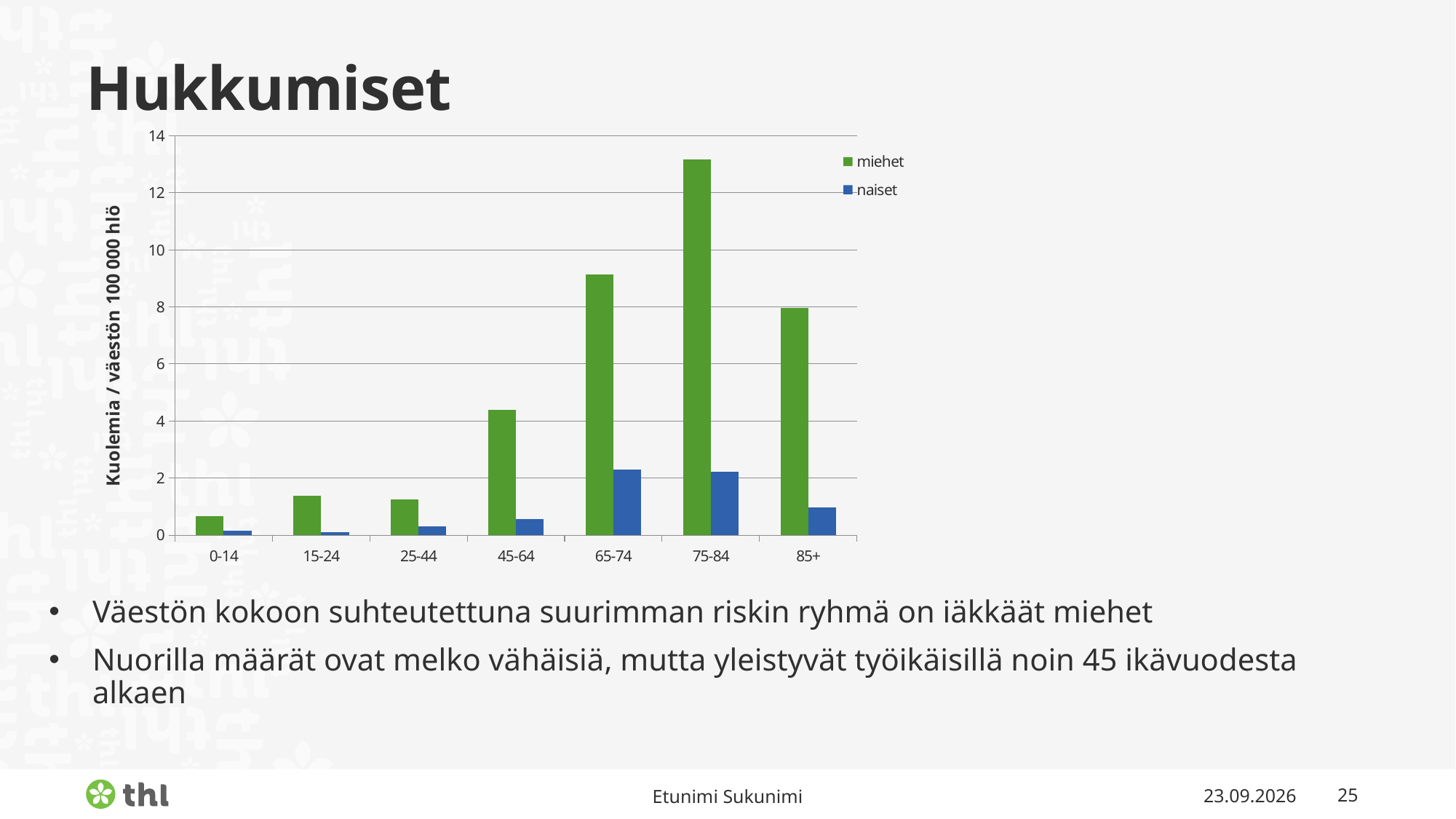
How many series does the chart legend list? 2 What is the label of the vertical axis of the chart? Kuolemia / väestön 100 000 hlö What kind of chart is shown on the slide? bar chart Is the value for miehet in the 65-74 age group greater or less than 8? greater How many age groups are shown on the x axis of the chart? 7 Which age group has the highest value for miehet? 75-84 In the 75-84 age group, which series has the larger value, miehet or naiset? miehet Which age group has the lowest value for miehet? 0-14 Is the value for naiset in the 85+ age group greater or less than 2? less Is the value for miehet in the 45-64 age group greater or less than 6? less Which is larger for miehet: the value for 65-74 or the value for 85+? 65-74